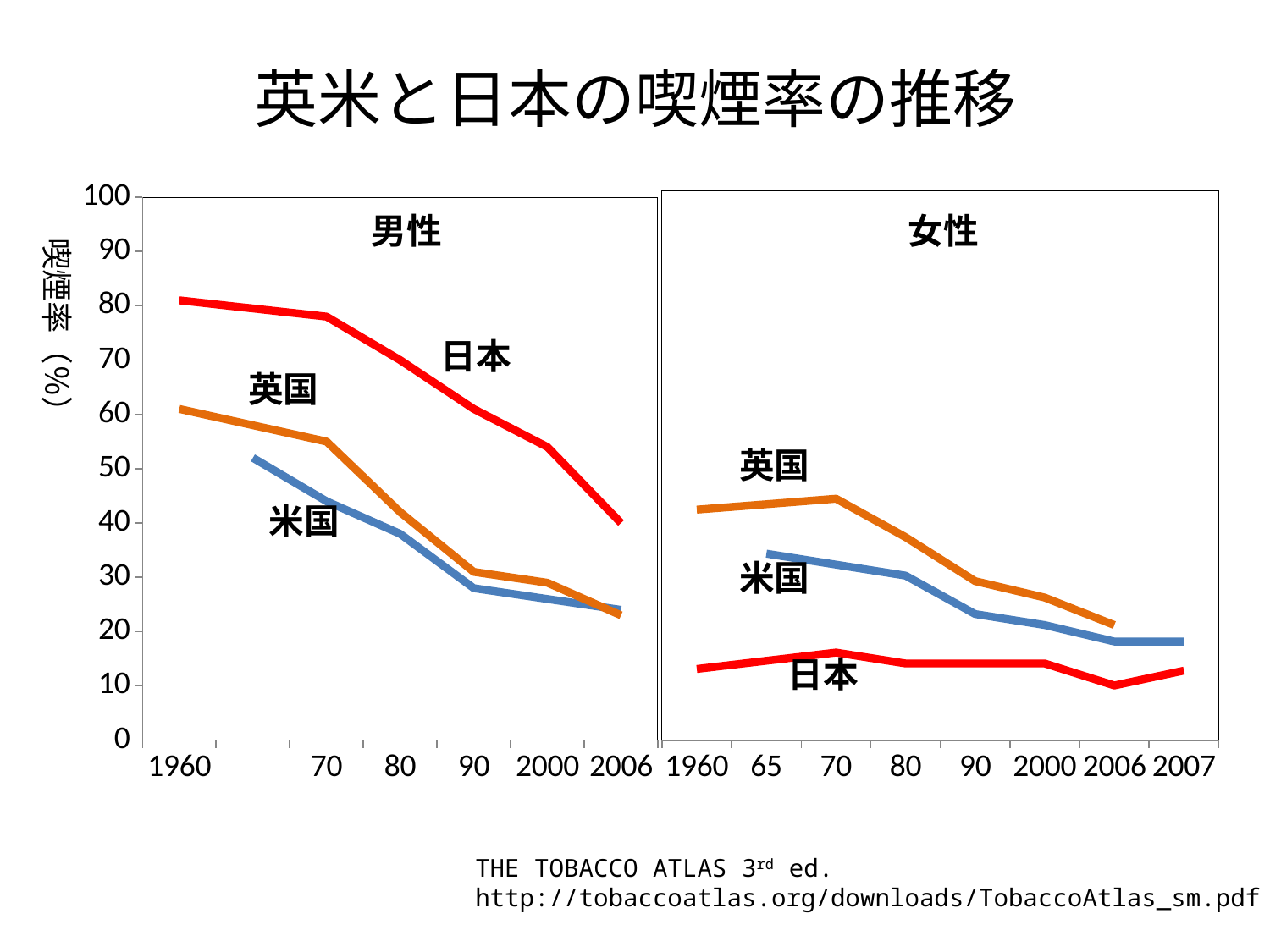
In the 女性 chart, which country has the lowest smoking rate across the whole period? 日本 What kind of chart is used on the slide for the 男性 and 女性 panels? line chart In the 男性 chart, which is larger in 2006, the value for 日本 or the value for 英国? 日本 In the 男性 chart, does the smoking rate for 日本 rise or fall from 1960 to 2006? fall In the 男性 chart, is the value for 英国 in 1960 greater or less than 50? greater In the 女性 chart, is the value for 英国 in 1970 greater or less than 40? greater In the 男性 chart, how many countries' lines are plotted? 3 What is the label on the vertical axis of the charts? 喫煙率 (%) In the 女性 chart, is the value for 日本 in 1960 greater or less than 20? less In the 男性 chart, which country has the highest smoking rate in 1960? 日本 In the 女性 chart, how many year labels are shown on the x axis? 8